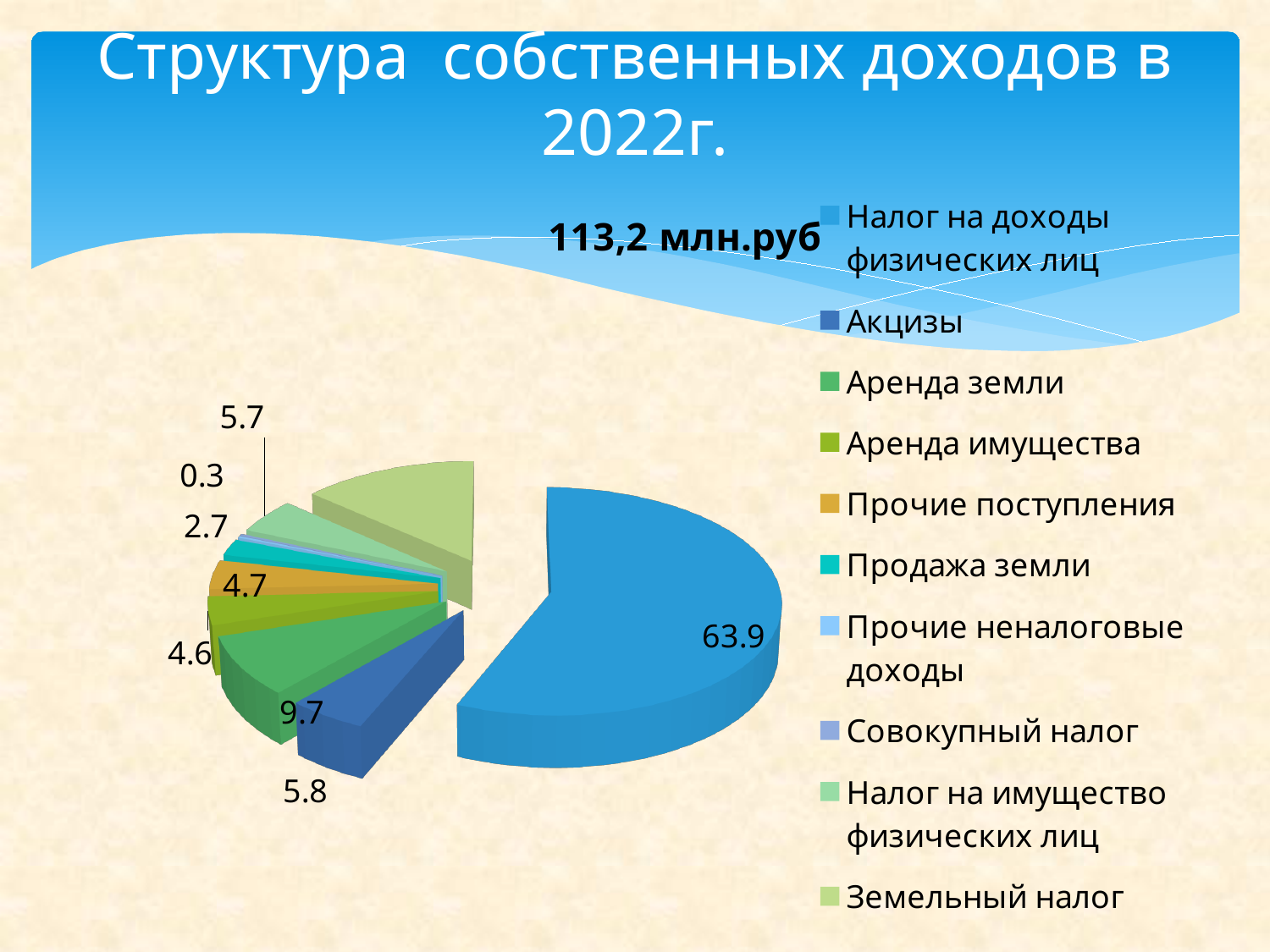
What value is shown for Налог на доходы физических лиц? 63.9 What kind of chart is shown on the slide? pie chart What value is shown for Продажа земли? 2.7 What value is shown for Прочие поступления? 4.7 Which is larger, the value for Аренда земли or the value for Акцизы? Аренда земли What value is shown for Аренда имущества? 4.6 What is the difference between the values for Налог на доходы физических лиц and Аренда земли? 54.2 Which category has the largest slice of the pie? Налог на доходы физических лиц What total amount is printed above the chart? 113,2 млн.руб What value is shown for Аренда земли? 9.7 What value is shown for Акцизы? 5.8 How many entries does the legend list? 10